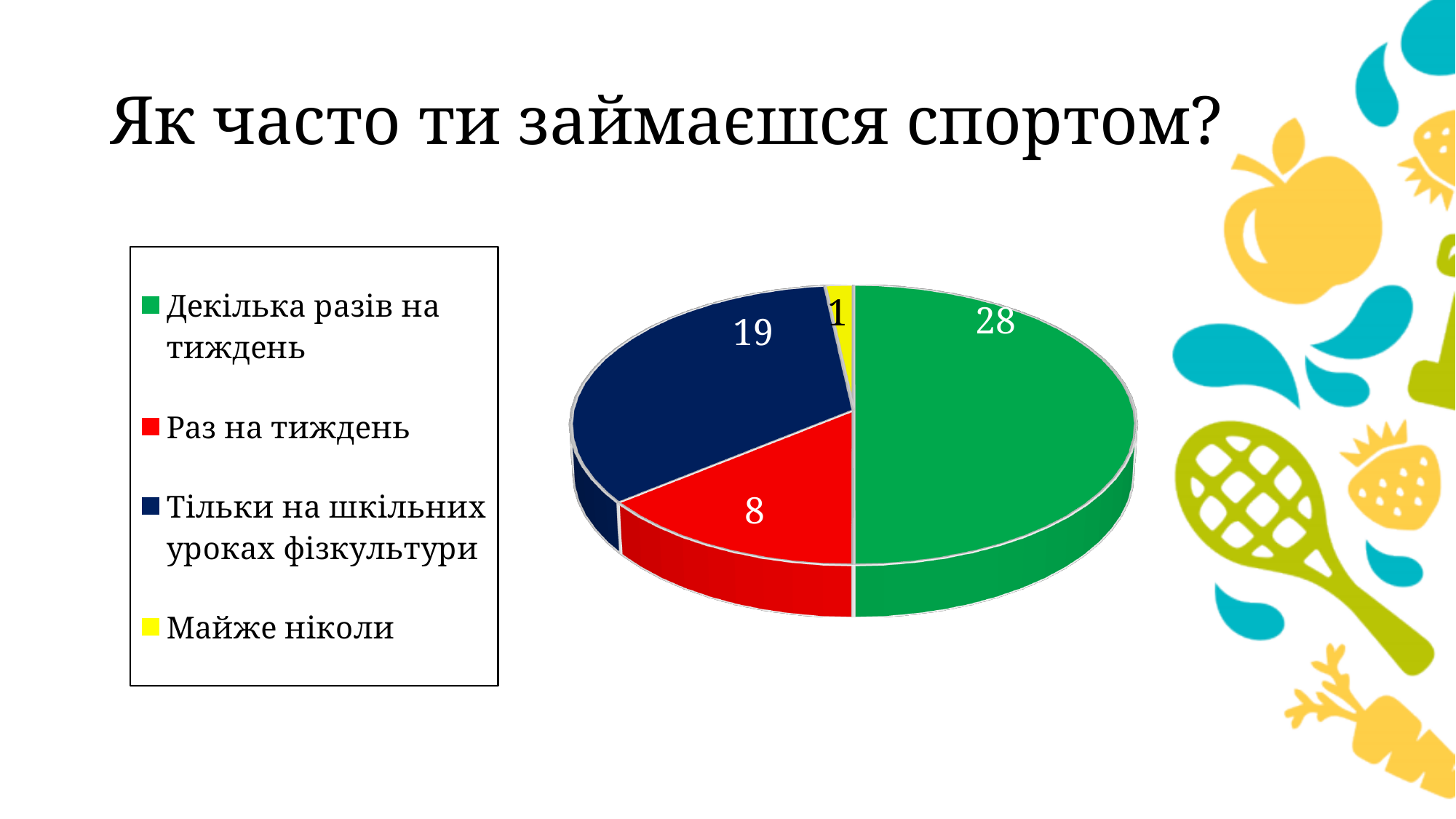
What is the value for "Тільки на шкільних уроках фізкультури"? 19 Which is larger, the value for "Раз на тиждень" or the value for "Тільки на шкільних уроках фізкультури"? Тільки на шкільних уроках фізкультури Which category has the largest slice? Декілька разів на тиждень What is the value for "Майже ніколи"? 1 What kind of chart is shown on the slide? pie chart What share of the pie does "Декілька разів на тиждень" represent? 50% What colour is the slice for "Майже ніколи"? yellow Which category has the smallest slice? Майже ніколи How many categories does the pie chart have? 4 What is the difference between the values for "Декілька разів на тиждень" and "Тільки на шкільних уроках фізкультури"? 9 What is the value for "Раз на тиждень"? 8 What is the value for "Декілька разів на тиждень"? 28